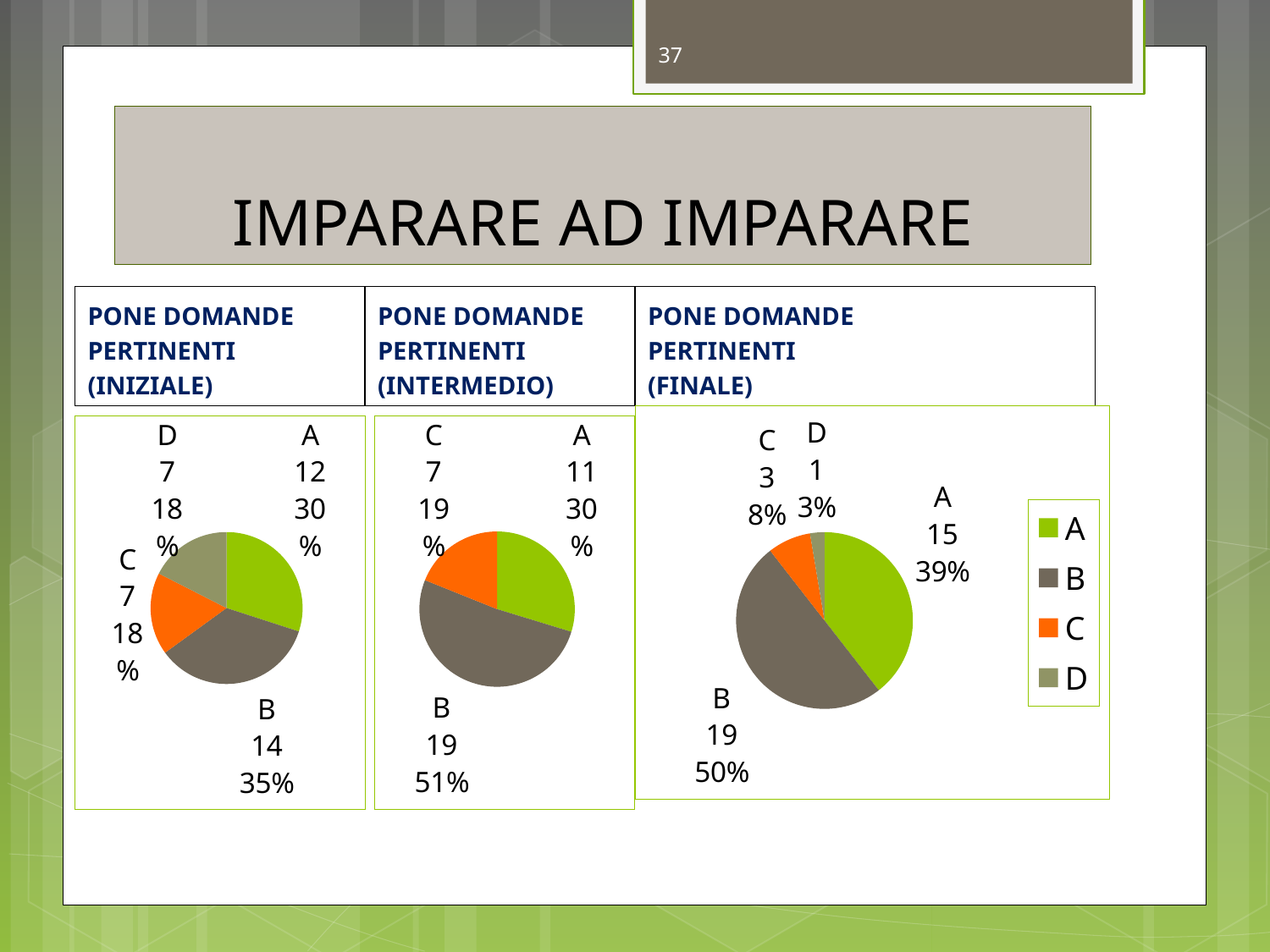
What type of chart is used for PONE DOMANDE PERTINENTI (FINALE)? Pie chart In the PONE DOMANDE PERTINENTI (INTERMEDIO) chart, what percentage share does C have? 19% In the PONE DOMANDE PERTINENTI (FINALE) chart, which category has the smallest slice? D In the PONE DOMANDE PERTINENTI (FINALE) chart, what is the value for A? 15 How many entries does the legend of the PONE DOMANDE PERTINENTI (FINALE) chart list? 4 In the PONE DOMANDE PERTINENTI (FINALE) chart, what is the difference between the values for B and C? 16 In the PONE DOMANDE PERTINENTI (INIZIALE) chart, what percentage share does A have? 30% In the PONE DOMANDE PERTINENTI (INTERMEDIO) chart, what is the value for B? 19 In the PONE DOMANDE PERTINENTI (FINALE) chart, which is larger, the value for A or the value for B? B In the PONE DOMANDE PERTINENTI (INIZIALE) chart, what is the value for B? 14 How many slices does the PONE DOMANDE PERTINENTI (INTERMEDIO) pie chart have? 3 In the PONE DOMANDE PERTINENTI (INIZIALE) chart, which category has the largest slice? B